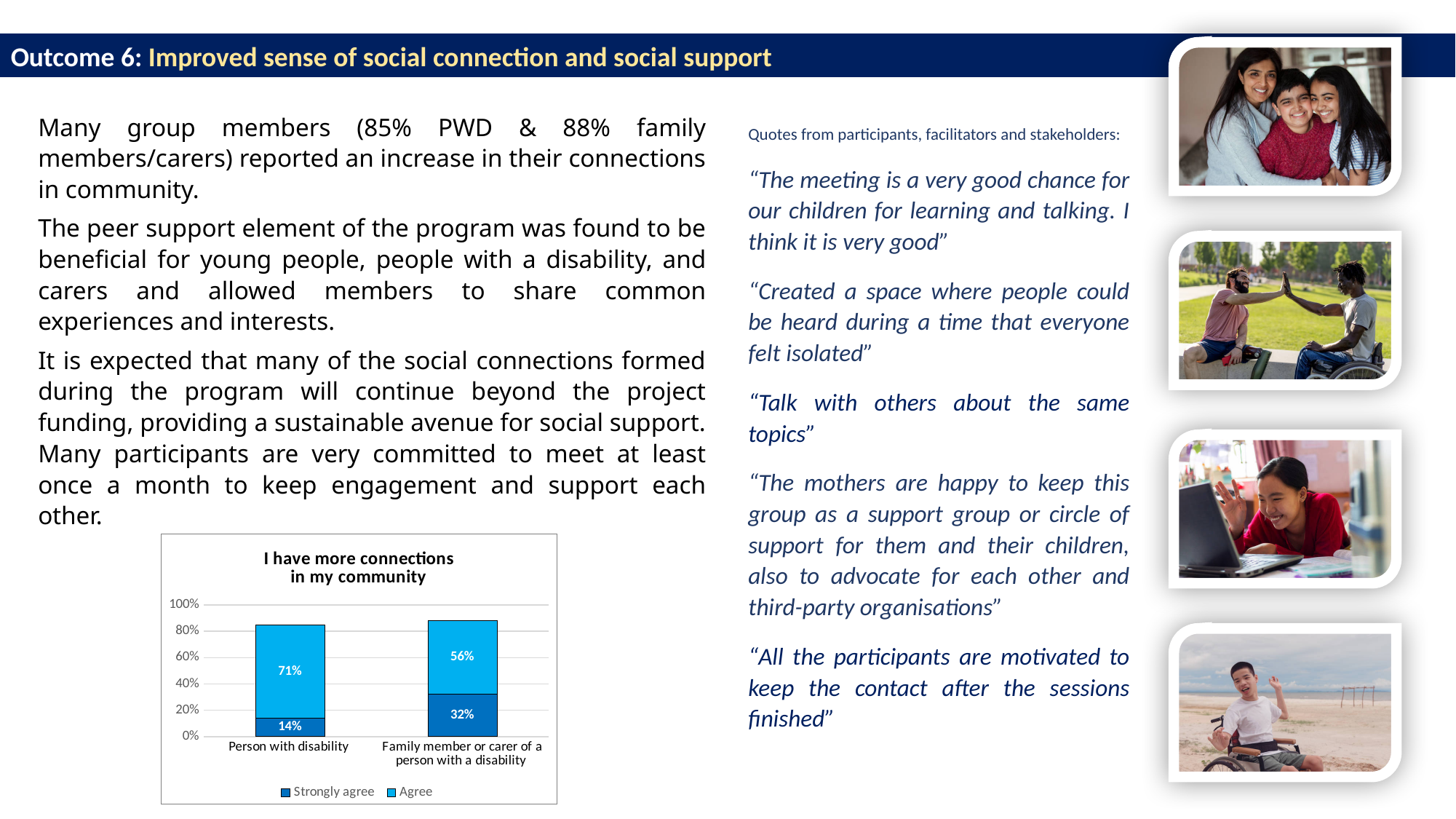
Which category has the higher 'Strongly agree' value? Family member or carer of a person with a disability What is the total of the stacked bar for 'Family member or carer of a person with a disability'? 88% What is the 'Strongly agree' value for 'Person with disability'? 14% What type of chart is shown on the slide? Stacked bar chart How many series does the chart legend list? 2 What is the 'Agree' value for 'Family member or carer of a person with a disability'? 56% What is the 'Agree' value for 'Person with disability'? 71% What is the total of the stacked bar for 'Person with disability'? 85% What is the title of the chart? I have more connections in my community What is the difference between the 'Agree' values for 'Person with disability' and 'Family member or carer of a person with a disability'? 15% What is the 'Strongly agree' value for 'Family member or carer of a person with a disability'? 32% How many categories are shown on the x axis of the chart? 2